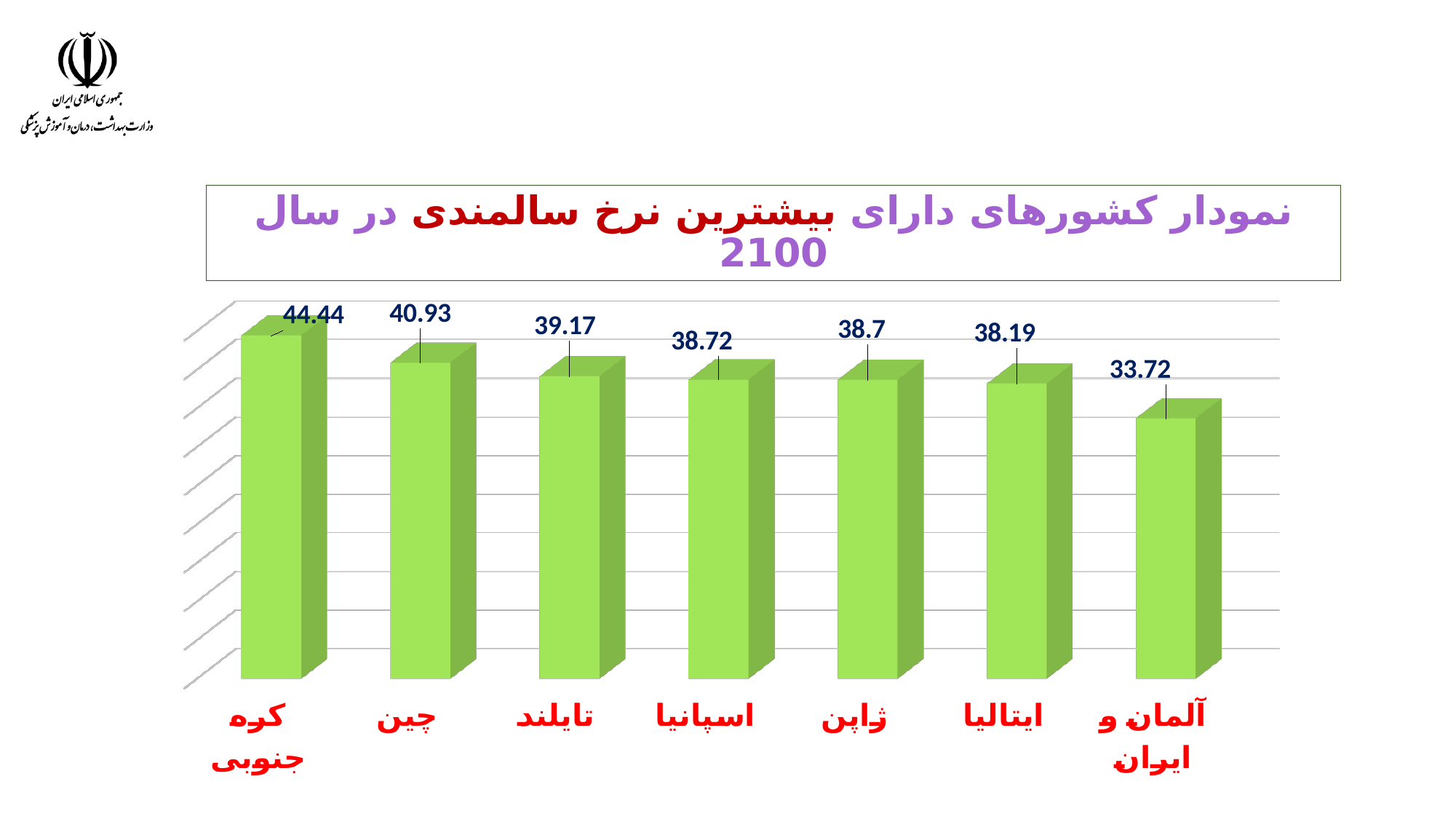
Which category has the highest value? کره جنوبی (South Korea) What is the value shown for چین (China)? 40.93 What is the value shown for آلمان و ایران (Germany and Iran)? 33.72 What is the difference between the values for تایلند (Thailand) and آلمان و ایران (Germany and Iran)? 5.45 Which category has the lowest value? آلمان و ایران (Germany and Iran) What kind of chart is shown on the slide? Bar chart Which is larger, the value for اسپانیا (Spain) or the value for ایتالیا (Italy)? اسپانیا (Spain) What is the difference between the values for کره جنوبی (South Korea) and چین (China)? 3.51 How many categories are shown in the chart? 7 Do the values rise or fall from left to right across the categories? Fall What is the value shown for ایتالیا (Italy)? 38.19 What is the value shown for کره جنوبی (South Korea)? 44.44